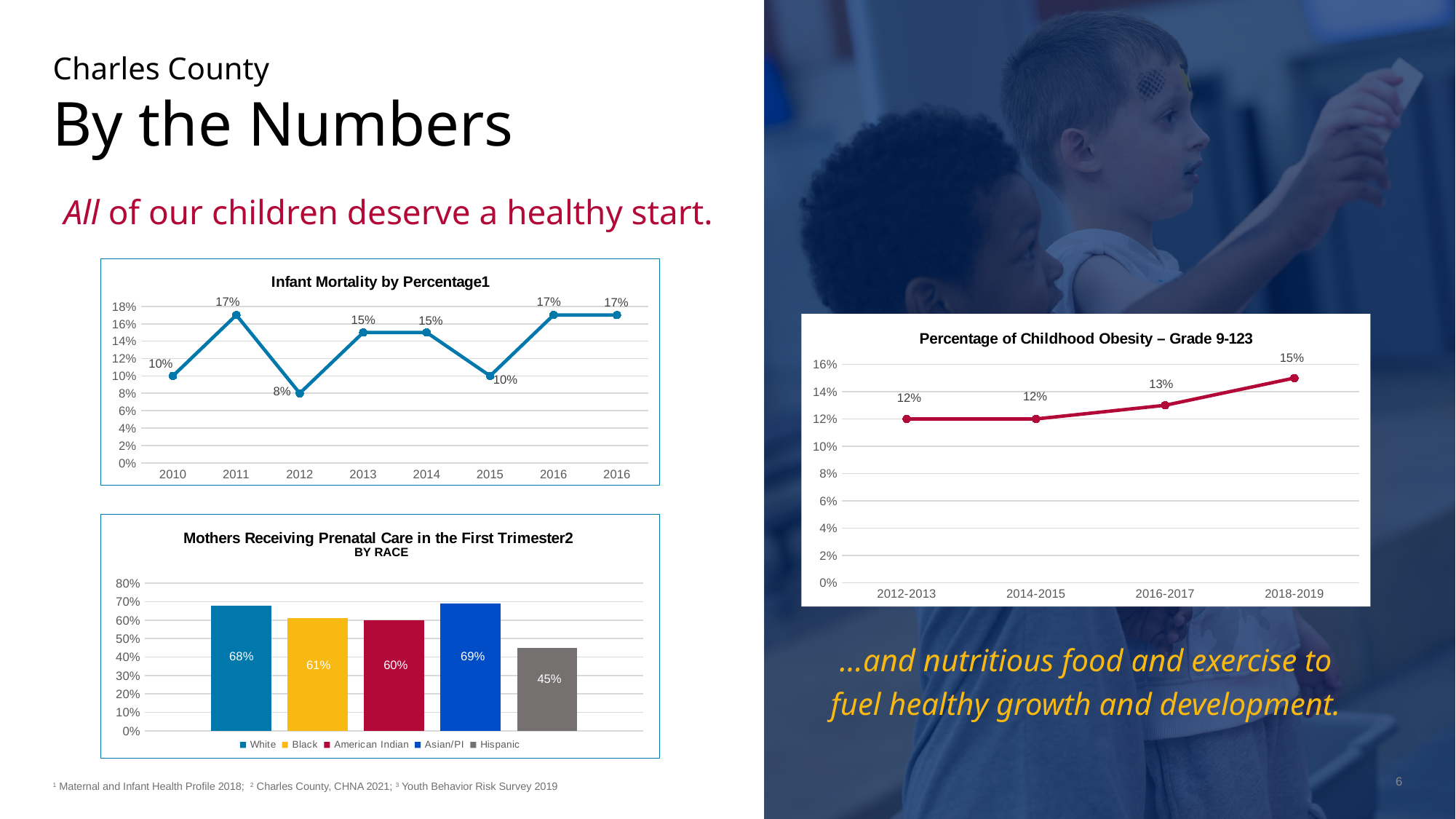
In the 'Mothers Receiving Prenatal Care in the First Trimester' chart, what is the value for Hispanic? 45% In the 'Infant Mortality by Percentage' chart, what is the value for 2010? 10% In the 'Percentage of Childhood Obesity – Grade 9-12' chart, what is the value for 2018-2019? 15% What kind of chart is 'Mothers Receiving Prenatal Care in the First Trimester'? bar chart In the 'Infant Mortality by Percentage' chart, what is the value for 2012? 8% In the 'Infant Mortality by Percentage' chart, what is the difference between the 2011 value and the 2012 value? 9% In the 'Mothers Receiving Prenatal Care in the First Trimester' chart, which race has the highest value? Asian/PI What kind of chart is 'Infant Mortality by Percentage'? line chart In the 'Infant Mortality by Percentage' chart, which year has the lowest value? 2012 In the 'Percentage of Childhood Obesity – Grade 9-12' chart, do the values rise or fall from 2012-2013 to 2018-2019? rise In the 'Mothers Receiving Prenatal Care in the First Trimester' chart, how many categories does the legend list? 5 In the 'Mothers Receiving Prenatal Care in the First Trimester' chart, what is the difference between the White value and the Hispanic value? 23%